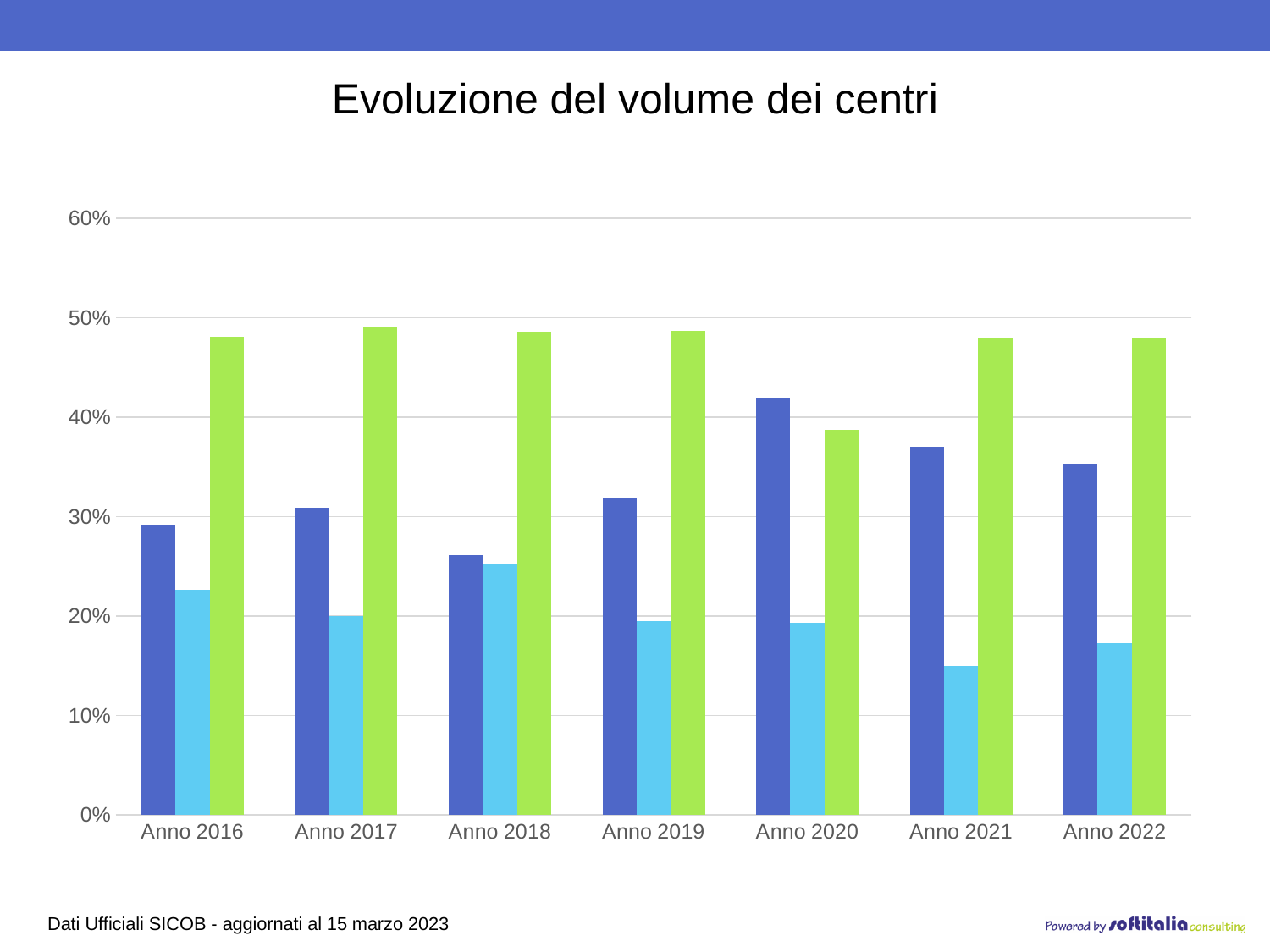
Is the value of the dark blue bar for Anno 2018 greater or less than 30%? less For Anno 2016, which is larger: the dark blue bar or the light blue bar? the dark blue bar In which year is the light blue bar the lowest? Anno 2021 How many years (categories) are shown on the x axis? 7 How many bars are plotted for each year? 3 What kind of chart is shown on the slide? bar chart Is the value of the green bar for Anno 2020 greater or less than 40%? less For Anno 2020, which is larger: the dark blue bar or the green bar? the dark blue bar What is the title of the chart? Evoluzione del volume dei centri Is the value of the light blue bar for Anno 2021 greater or less than 20%? less In which year is the dark blue bar the highest? Anno 2020